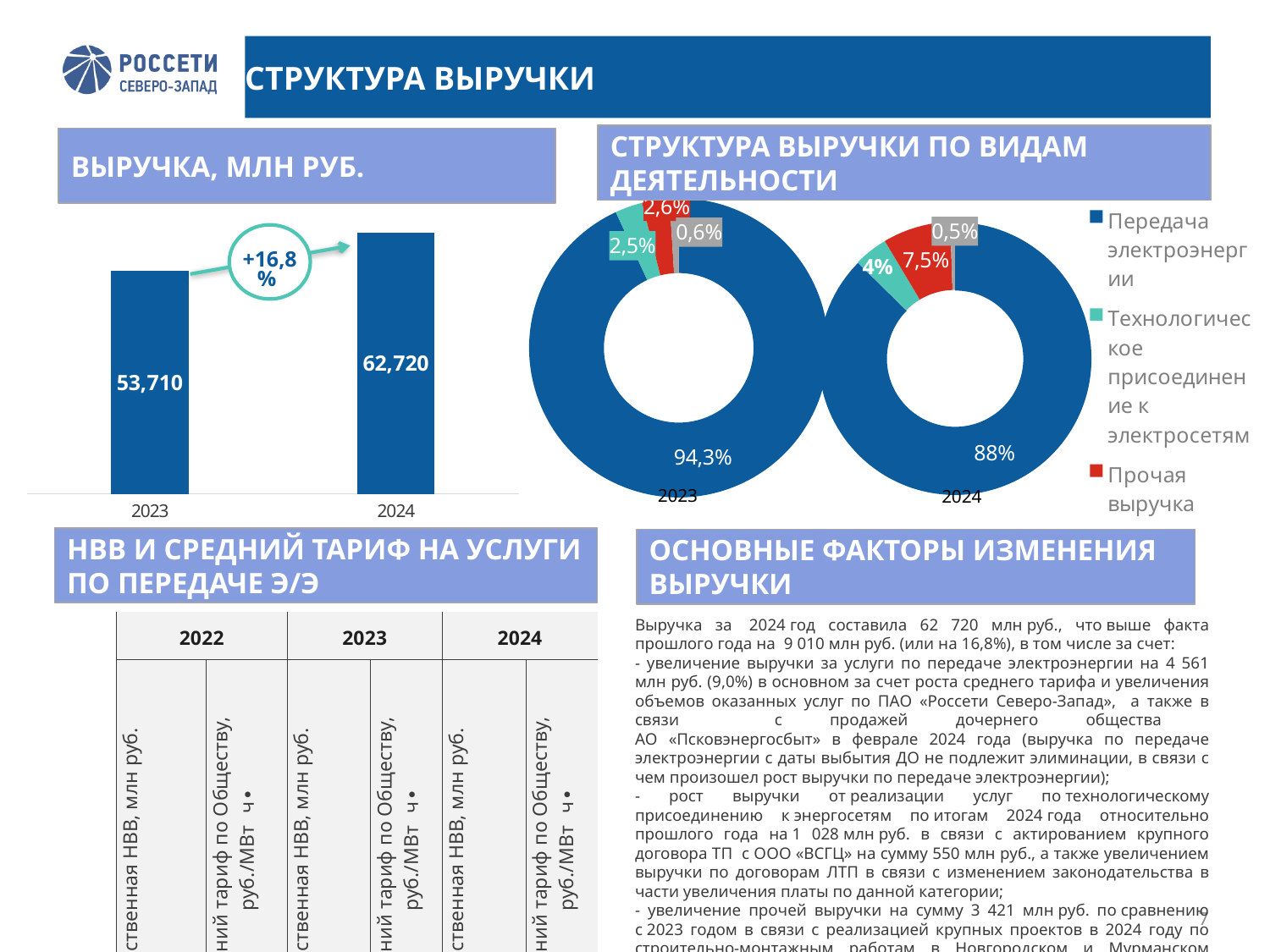
What type of chart is 'ВЫРУЧКА, МЛН РУБ.'? bar chart On the 'СТРУКТУРА ВЫРУЧКИ ПО ВИДАМ ДЕЯТЕЛЬНОСТИ' chart, how many entries does the legend list? 3 On the 'СТРУКТУРА ВЫРУЧКИ ПО ВИДАМ ДЕЯТЕЛЬНОСТИ' chart, what share does 'Технологическое присоединение к электросетям' have in 2023? 2,5% On the 'ВЫРУЧКА, МЛН РУБ.' bar chart, which year has the higher value? 2024 On the 'ВЫРУЧКА, МЛН РУБ.' bar chart, how many years are plotted? 2 On the 'ВЫРУЧКА, МЛН РУБ.' bar chart, what percentage change is shown between 2023 and 2024? +16,8% On the 'СТРУКТУРА ВЫРУЧКИ ПО ВИДАМ ДЕЯТЕЛЬНОСТИ' chart, what share does 'Передача электроэнергии' have in 2023? 94,3% On the 'ВЫРУЧКА, МЛН РУБ.' bar chart, what is the value for 2023? 53,710 On the 'ВЫРУЧКА, МЛН РУБ.' bar chart, what is the difference between the 2024 and 2023 values? 9,010 On the 'СТРУКТУРА ВЫРУЧКИ ПО ВИДАМ ДЕЯТЕЛЬНОСТИ' chart, what share does 'Передача электроэнергии' have in 2024? 88% On the 'ВЫРУЧКА, МЛН РУБ.' bar chart, what is the value for 2024? 62,720